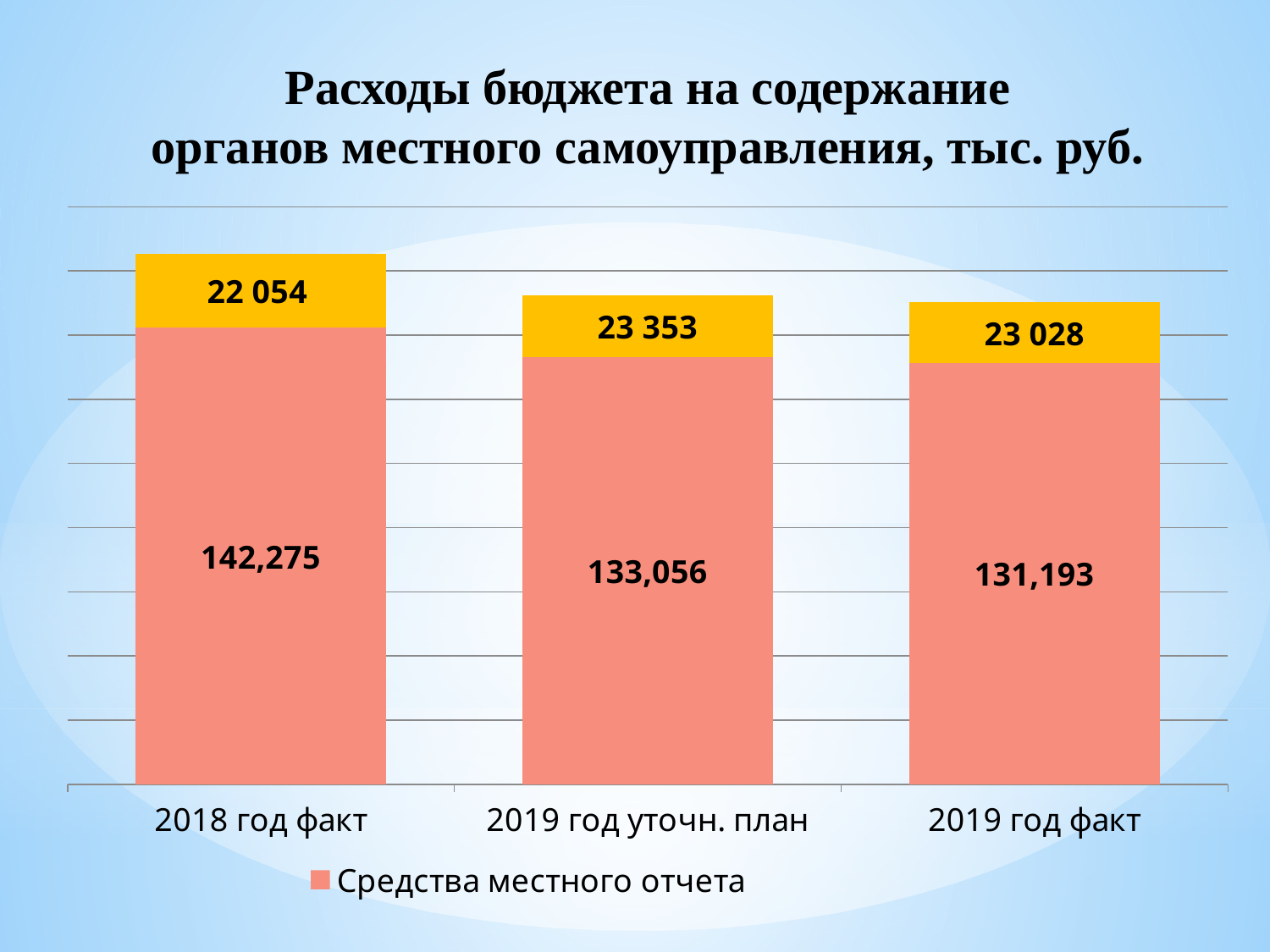
Which category has the lowest value on its yellow segment? 2018 год факт What is the value of the 'Средства местного отчета' series for '2019 год уточн. план'? 133,056 Which category has the highest value for the 'Средства местного отчета' series? 2018 год факт How many series does the legend list? 1 What is the value of the 'Средства местного отчета' series for '2019 год факт'? 131,193 What value is printed on the yellow segment of the '2019 год уточн. план' bar? 23 353 What is the value of the 'Средства местного отчета' series for '2018 год факт'? 142,275 What kind of chart is shown on the slide? Stacked bar chart How many categories are shown on the x axis? 3 Which is larger: the yellow segment value for '2019 год уточн. план' or for '2019 год факт'? 2019 год уточн. план What is the difference between the 'Средства местного отчета' values for '2018 год факт' and '2019 год факт'? 11,082 What value is printed on the yellow segment of the '2018 год факт' bar? 22 054